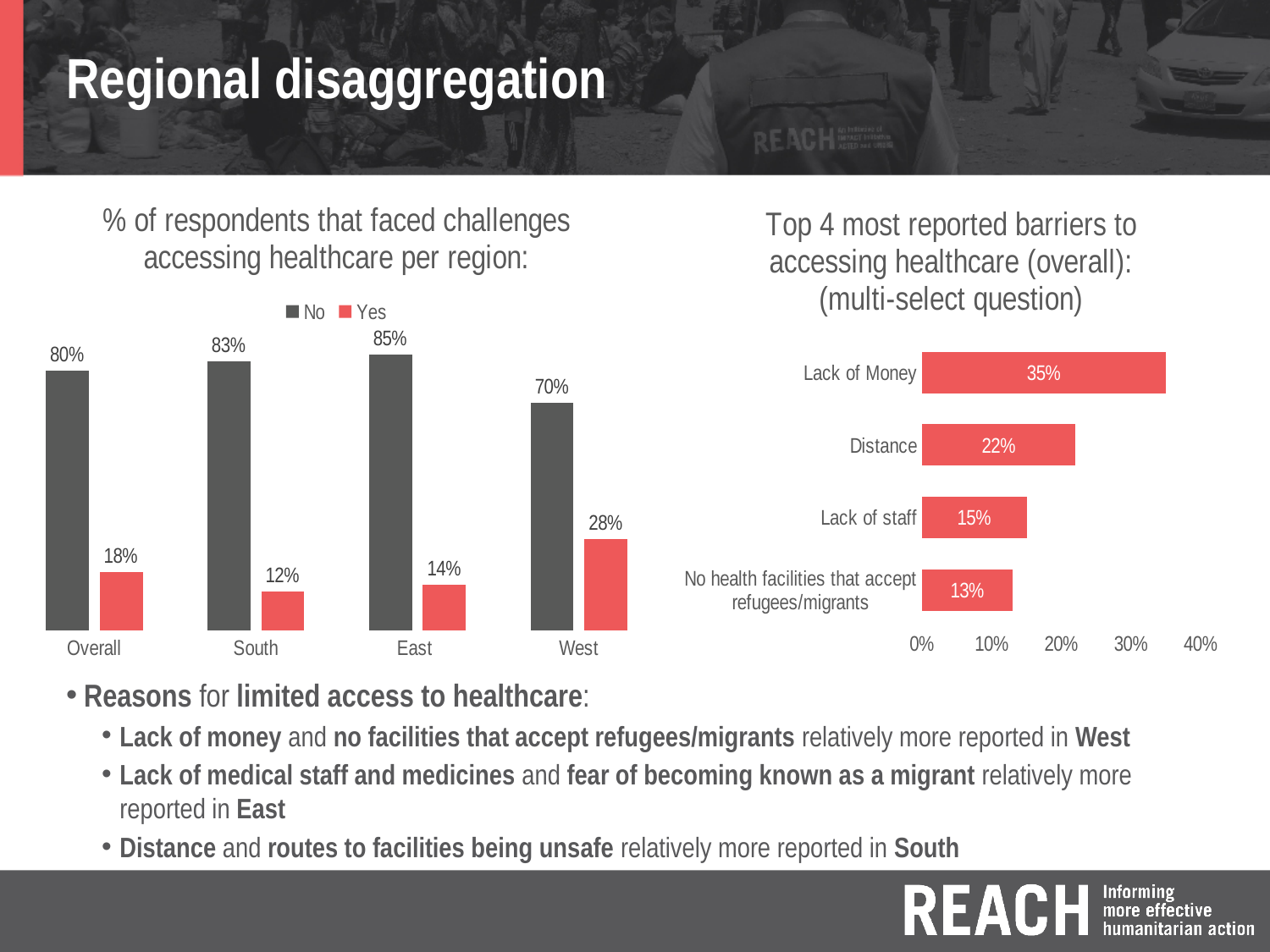
In the chart 'Top 4 most reported barriers to accessing healthcare (overall)', what is the difference between Lack of Money and Lack of staff? 20% In the chart '% of respondents that faced challenges accessing healthcare per region', which region has the highest 'Yes' value? West In the chart 'Top 4 most reported barriers to accessing healthcare (overall)', what is the value for Distance? 22% In the chart '% of respondents that faced challenges accessing healthcare per region', what is the difference between the 'No' values for East and West? 15% In the chart '% of respondents that faced challenges accessing healthcare per region', what is the 'No' value for East? 85% In the chart '% of respondents that faced challenges accessing healthcare per region', how many regions (categories) are shown on the x axis? 4 In the chart 'Top 4 most reported barriers to accessing healthcare (overall)', which barrier has the highest value? Lack of Money In the chart '% of respondents that faced challenges accessing healthcare per region', how many series does the legend list? 2 In the chart '% of respondents that faced challenges accessing healthcare per region', which region has the lowest 'Yes' value? South In the chart '% of respondents that faced challenges accessing healthcare per region', what is the 'Yes' value for West? 28% In the chart 'Top 4 most reported barriers to accessing healthcare (overall)', is the value for Lack of staff greater or less than 20%? less What kind of chart is 'Top 4 most reported barriers to accessing healthcare (overall)'? Bar chart